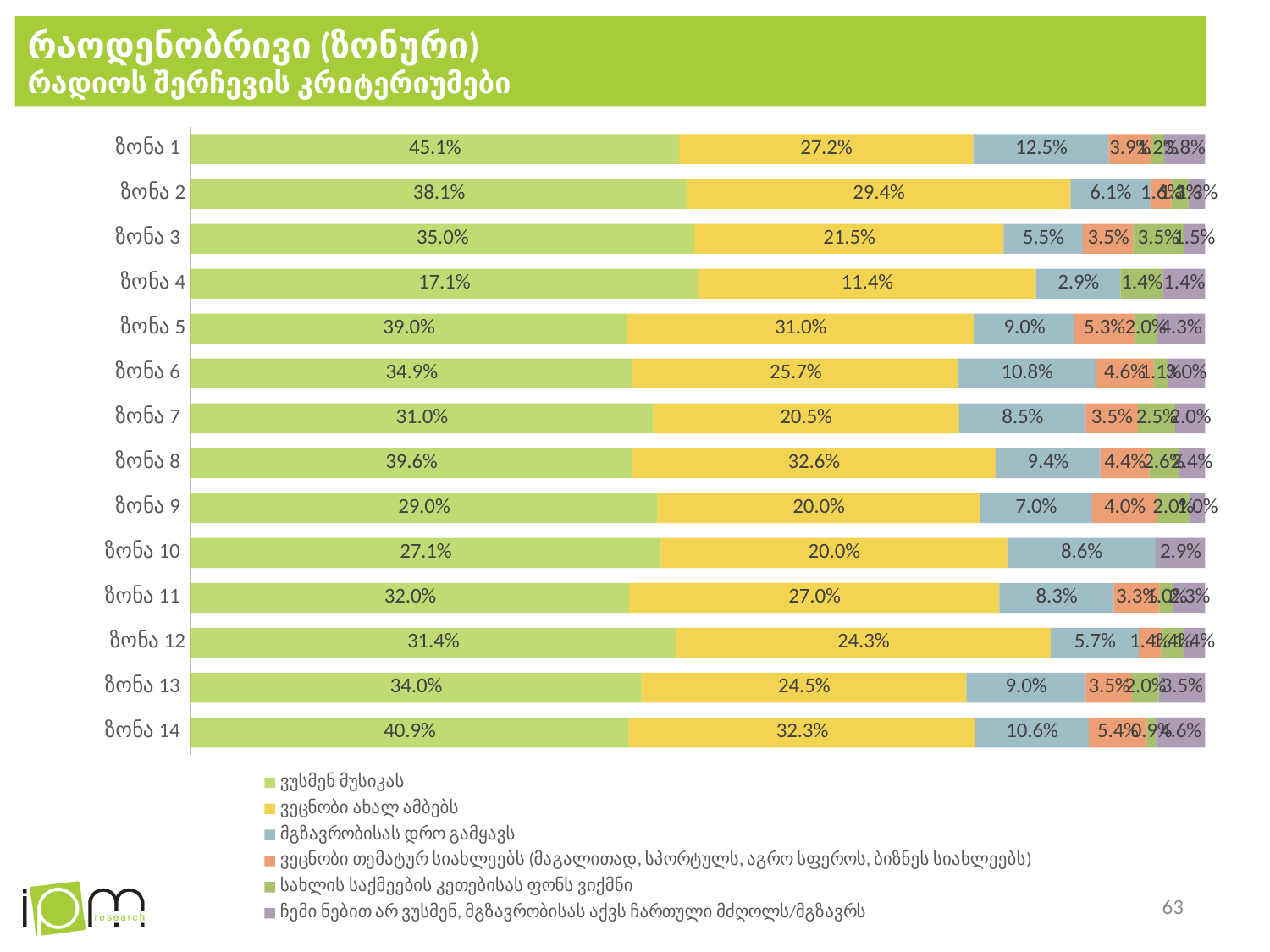
What is the value of the 'ვუსმენ მუსიკას' segment for ზონა 1? 45.1% What is the first entry in the chart legend? ვუსმენ მუსიკას What is the difference between the 'ვუსმენ მუსიკას' values for ზონა 1 and ზონა 2? 7.0% Which zone has the lowest value for 'ვუსმენ მუსიკას'? ზონა 4 Which zone has the highest value for 'ვუსმენ მუსიკას'? ზონა 1 What is the value of the 'ვუსმენ მუსიკას' segment for ზონა 14? 40.9% How many series does the legend list? 6 What is the value of the 'მგზავრობისას დრო გამყავს' segment for ზონა 6? 10.8% How many zones (categories) are shown on the chart? 14 What type of chart is shown on the slide? stacked bar chart What is the value of the 'ვეცნობი ახალ ამბებს' segment for ზონა 8? 32.6% Which is larger: the 'ვეცნობი ახალ ამბებს' value for ზონა 5 or for ზონა 7? ზონა 5